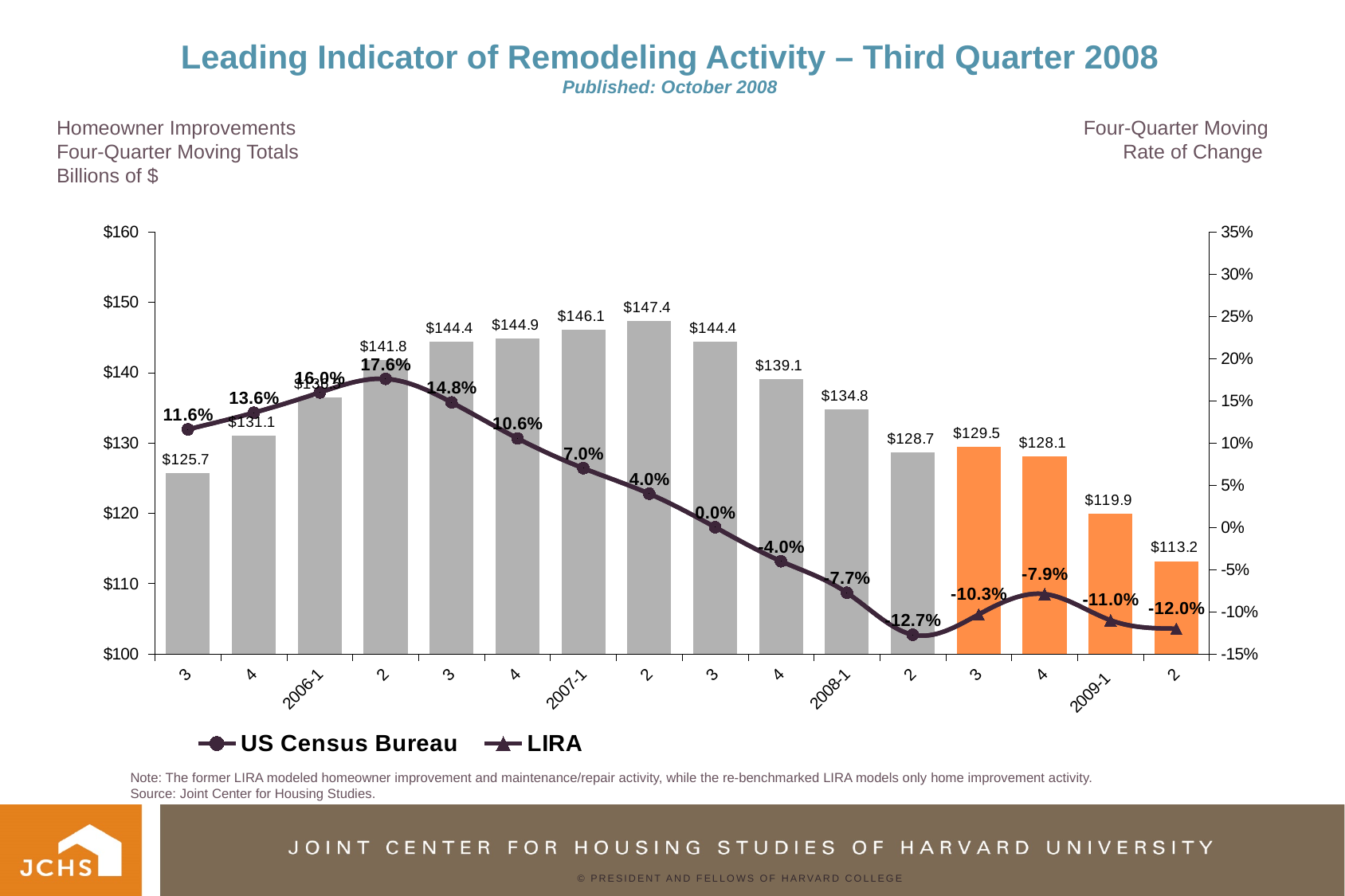
What is the difference between the highest bar ($147.4) and the lowest bar ($113.2)? $34.2 What rate of change is labeled on the line at the 2009-1 point? -11.0% What are the two entries in the legend? US Census Bureau and LIRA Which bar has the highest four-quarter moving total, and what is its value? The bar labeled 2 immediately after 2007-1 (2007 Q2), $147.4 What is the four-quarter moving total (in billions of $) shown for the bar labeled 2007-1? $146.1 How many series does the legend list? 2 What is the highest rate of change labeled on the line, and at which point does it occur? 17.6%, at the point after 2006-1 (2006 Q2) What kind of chart is this? A bar chart combined with a line chart Which is larger: the bar labeled $129.5 (2008 Q3) or the bar labeled $128.1 (2008 Q4)? 2008 Q3 ($129.5) How many bars are plotted on the chart? 16 Which bar has the lowest four-quarter moving total, and what is its value? The last bar (2009 Q2), $113.2 What rate of change is labeled on the line at the 2008-1 point? -7.7%